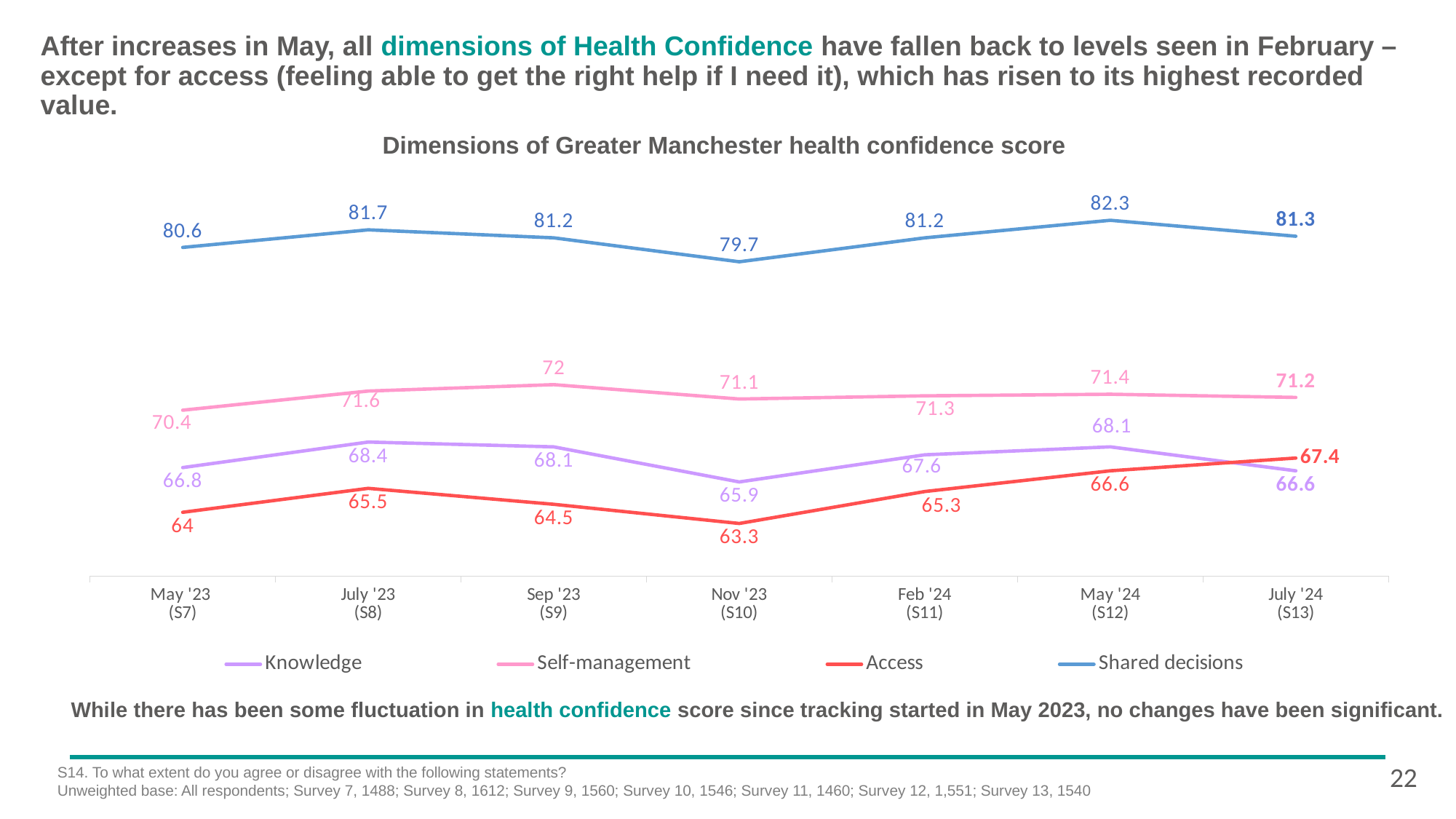
What is the Access score for July '24 (S13)? 67.4 How many survey periods are shown on the x axis? 7 What is the Knowledge score for Nov '23 (S10)? 65.9 What is the title of the chart? Dimensions of Greater Manchester health confidence score What is the Self-management score for Sep '23 (S9)? 72 How many series does the legend list? 4 Which is larger in July '24 (S13): the Access score or the Knowledge score? Access In which survey period is the Shared decisions score highest? May '24 (S12) In which survey period is the Access score lowest? Nov '23 (S10) What kind of chart is shown on the slide? Line chart What is the Shared decisions score for May '24 (S12)? 82.3 What is the difference between the Knowledge score in May '24 (S12) and July '24 (S13)? 1.5